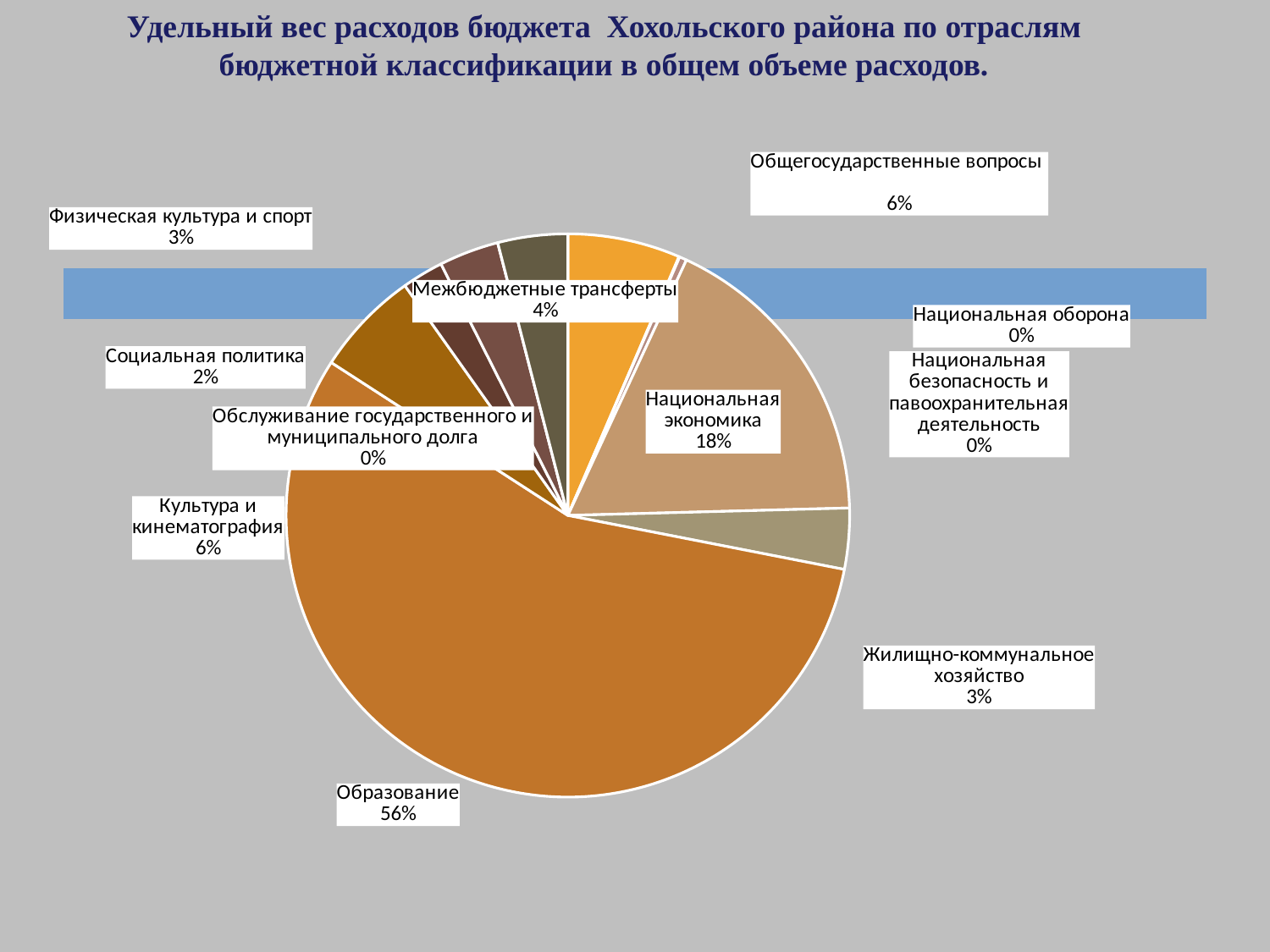
What is the difference between the shares of Образование and Национальная экономика? 38% What kind of chart is shown on the slide? pie chart Which is larger, Национальная экономика or Общегосударственные вопросы? Национальная экономика What percentage is shown for Межбюджетные трансферты? 4% What share of expenditures does Образование account for? 56% What percentage is shown for Национальная оборона? 0% What is the difference between the shares of Культура и кинематография and Физическая культура и спорт? 3% What is the value for Социальная политика? 2% What is the value shown for Национальная экономика? 18% Which category has the largest share of the pie? Образование How many categories are labelled on the pie chart? 11 Which district's budget expenditures does the chart title refer to? Хохольский район